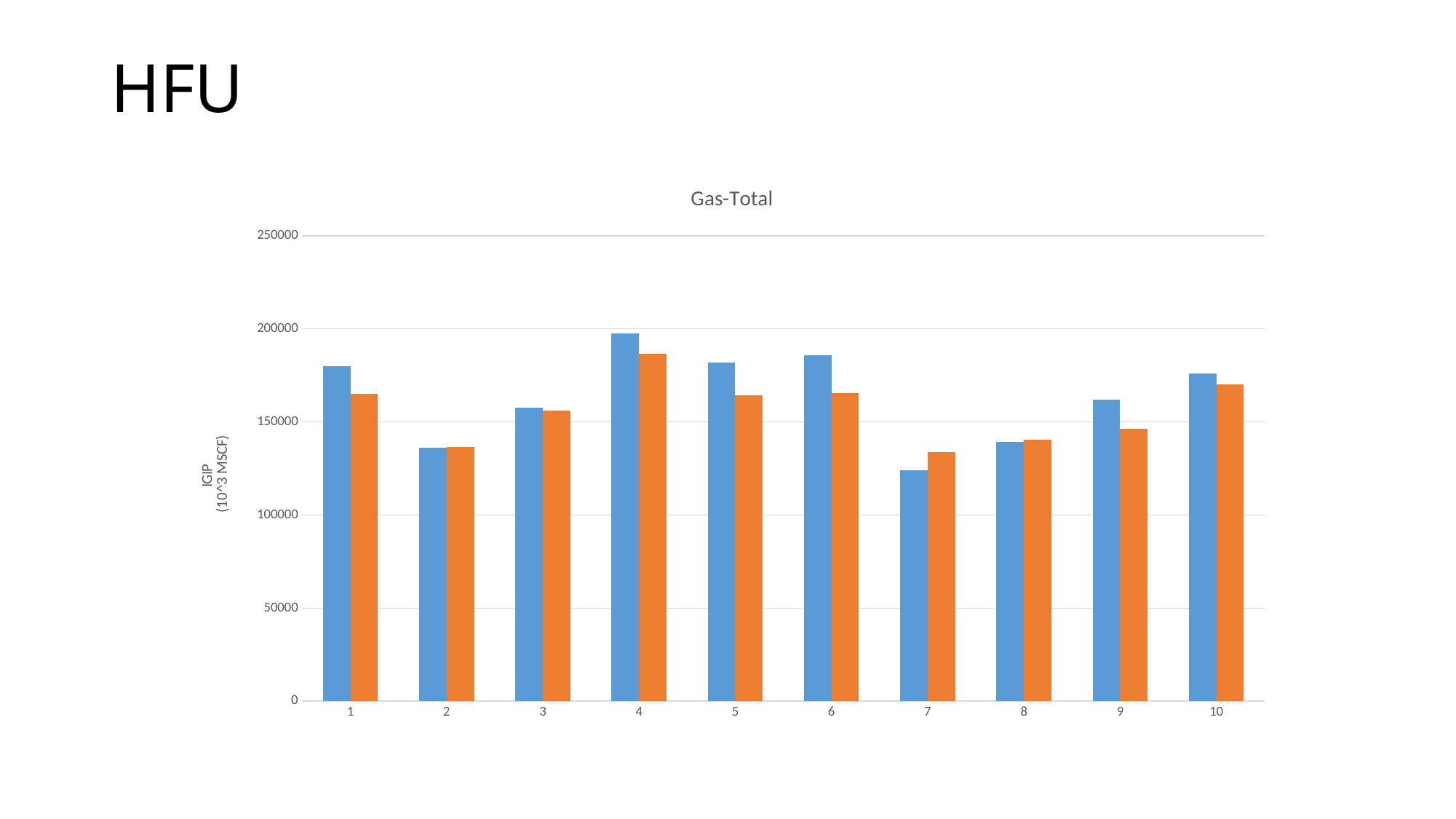
For which category is the blue bar the lowest? 7 For which category is the orange bar the highest? 4 Is the blue bar for category 4 greater or less than 150000? greater Is the blue bar for category 7 greater or less than 150000? less For which category is the blue bar the highest? 4 How many categories are shown on the x axis of the chart? 10 What is the label of the vertical axis? IGIP (10^3 MSCF) Is the orange bar for category 2 greater or less than 150000? less For category 7, which bar is larger, the blue one or the orange one? orange What kind of chart is shown on the slide? bar chart For category 1, which bar is larger, the blue one or the orange one? blue What is the title of the chart? Gas-Total